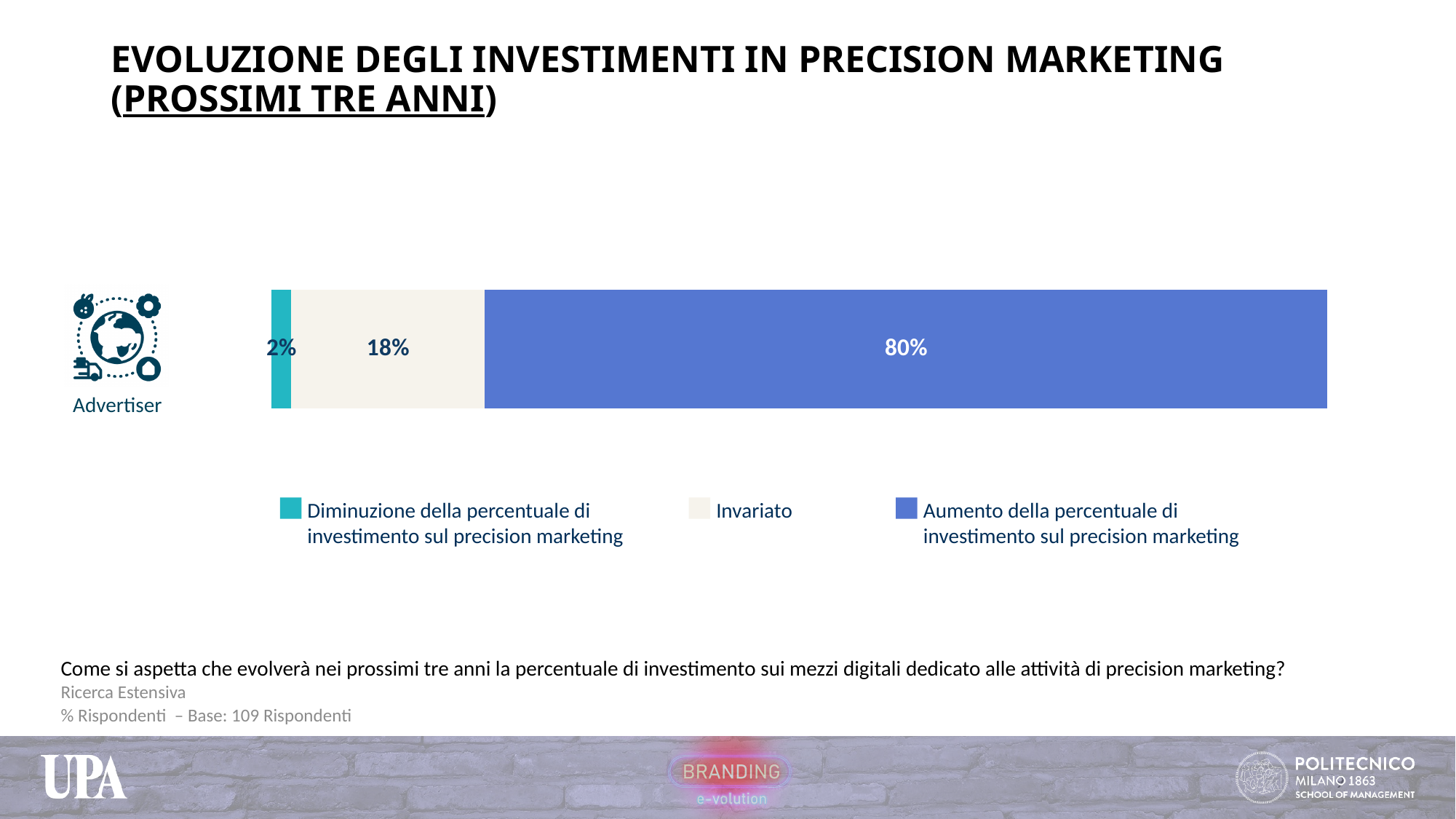
What percentage of advertisers expect a decrease in the share of investment in precision marketing ("Diminuzione della percentuale di investimento sul precision marketing")? 2% What is the label of the single category shown on the chart? Advertiser What percentage of advertisers expect the share of investment to remain unchanged ("Invariato")? 18% What kind of chart is shown on the slide? Stacked bar chart What is the difference in percentage points between "Aumento" (80%) and "Invariato" (18%)? 62 percentage points Which response option has the highest share among advertisers? Aumento della percentuale di investimento sul precision marketing What is the total of the three segments in the Advertiser bar? 100% Which response option has the lowest share among advertisers? Diminuzione della percentuale di investimento sul precision marketing What percentage of advertisers expect an increase in the share of investment in precision marketing ("Aumento della percentuale di investimento sul precision marketing")? 80% How many series does the legend list? 3 Which is larger: the share for "Invariato" or the share for "Diminuzione della percentuale di investimento sul precision marketing"? Invariato What colour is the segment representing "Invariato"? Light beige